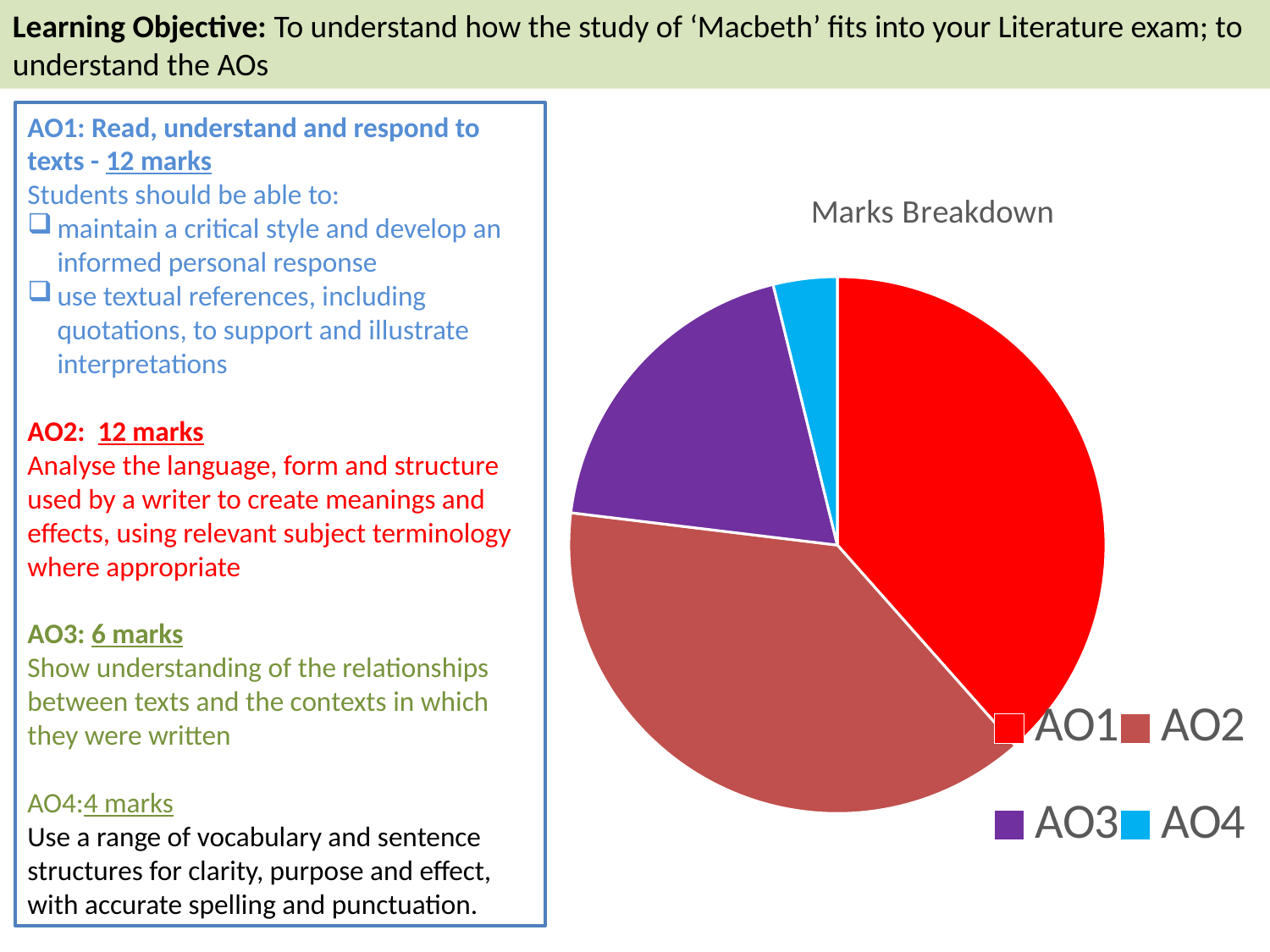
Which slice is larger, AO2 or AO4? AO2 How many slices does the pie chart have? 4 How many entries does the chart's legend list? 4 What colour is the AO1 slice in the pie chart? red Which slice is larger, AO3 or AO4? AO3 What is the title of the chart? Marks Breakdown Which slice is larger, AO1 or AO3? AO1 Which category has the smallest slice in the pie chart? AO4 What kind of chart is shown on the slide? pie chart